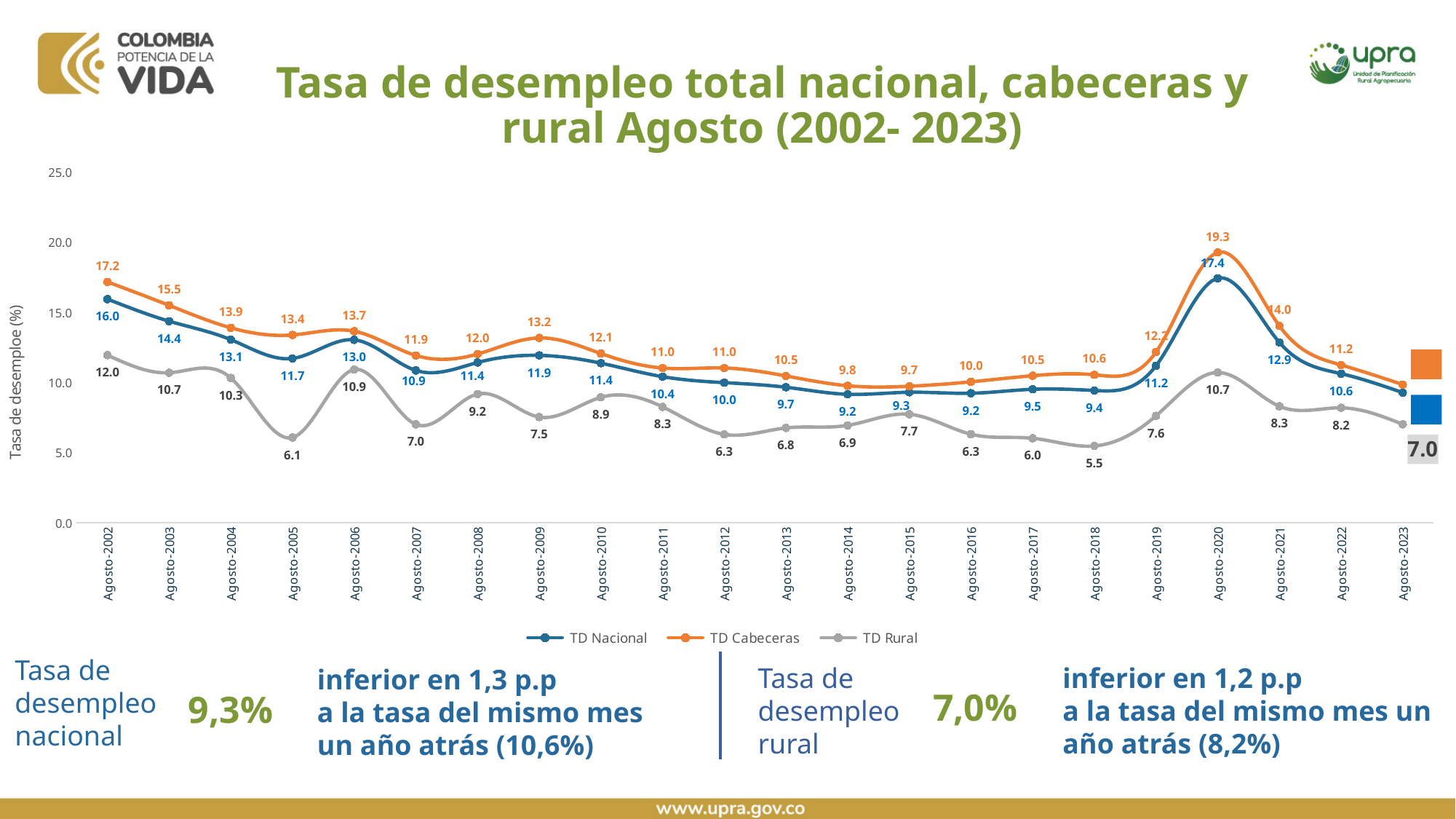
In which period does TD Nacional reach its highest value? Agosto-2020 Is the value of TD Cabeceras in Agosto-2020 greater or less than 15.0? greater What is the value of TD Cabeceras in Agosto-2020? 19.3 Which is larger for TD Rural: Agosto-2005 or Agosto-2007? Agosto-2007 How many series does the legend list? 3 What are the three series named in the legend? TD Nacional, TD Cabeceras, TD Rural What is the difference between TD Cabeceras and TD Nacional in Agosto-2020? 1.9 How many periods are plotted along the x axis? 22 What is the value of TD Rural in Agosto-2018? 5.5 In which period does TD Rural reach its lowest value? Agosto-2018 What kind of chart is shown on the slide? Line chart What is the value of TD Nacional in Agosto-2002? 16.0